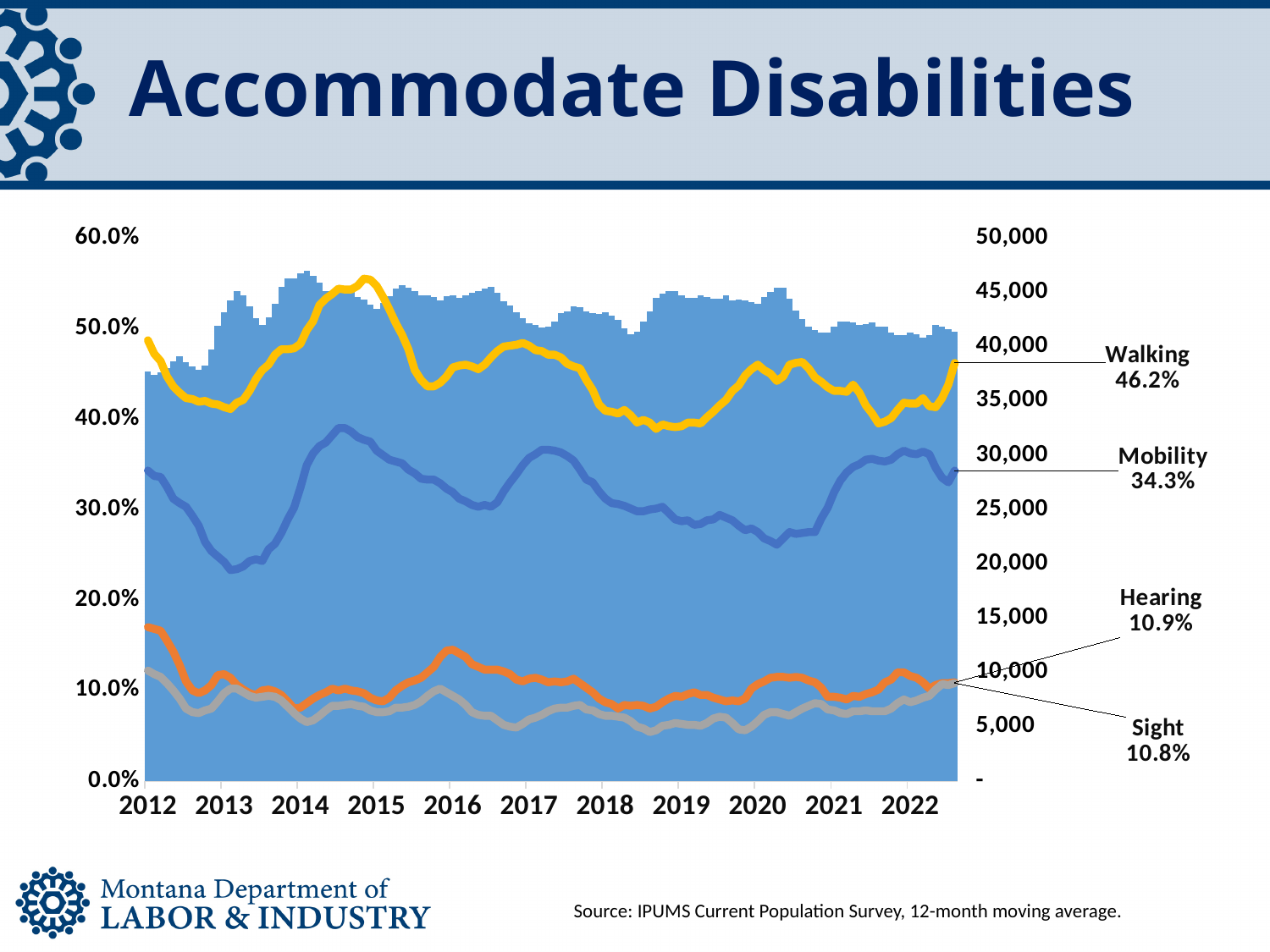
Which is larger at the end of the series, Walking or Mobility? Walking Is the peak of the Walking line around 2015 greater or less than 50.0%? greater What is the latest value shown for Walking? 46.2% Does the Mobility line rise or fall between 2020 and 2021? rise What is the latest value shown for Mobility? 34.3% Which labeled series has the highest latest value? Walking How many year labels are shown on the x axis? 11 What is the highest value shown on the right-hand axis? 50,000 What is the difference between the latest Walking value and the latest Mobility value? 11.9 percentage points What is the latest value shown for Hearing? 10.9% What is the latest value shown for Sight? 10.8% Is the Mobility line in 2013 greater or less than 30.0%? less